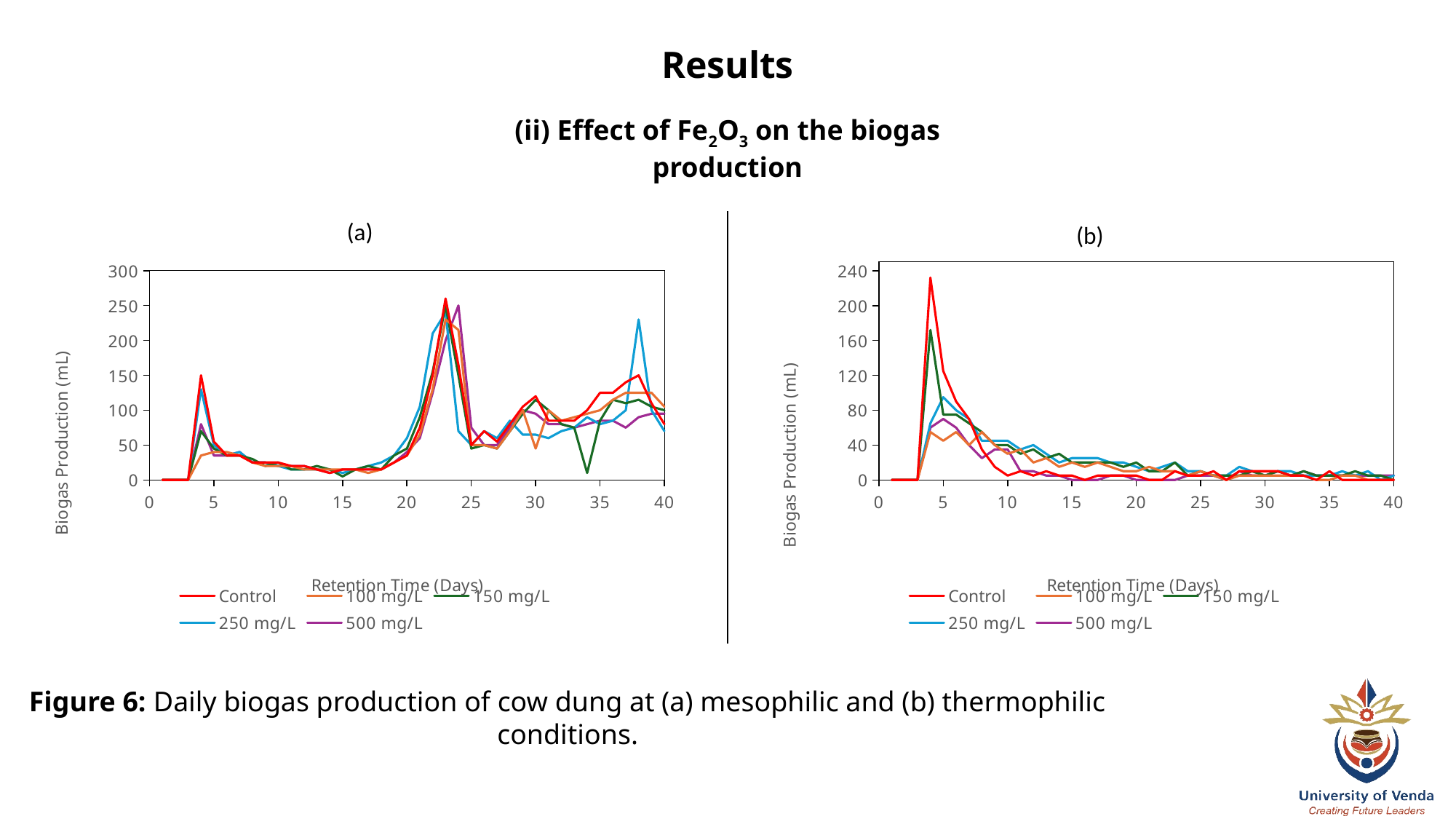
In chart (b), which series reaches the highest peak? Control What kind of chart is chart (a)? line chart In chart (b), is the Control value at day 4 greater or less than 200? greater What is the x-axis title of chart (b)? Retention Time (Days) In chart (a), is the Control value at day 23 greater or less than 200? greater In chart (b), at day 4, which is larger: Control or 100 mg/L? Control How many series does the legend of chart (b) list? 5 In chart (a), is the 250 mg/L value at day 38 greater or less than 200? greater In chart (a), which series has the highest value at day 4? Control In chart (b), does the Control series rise or fall between day 4 and day 10? fall What is the y-axis title of chart (a)? Biogas Production (mL)